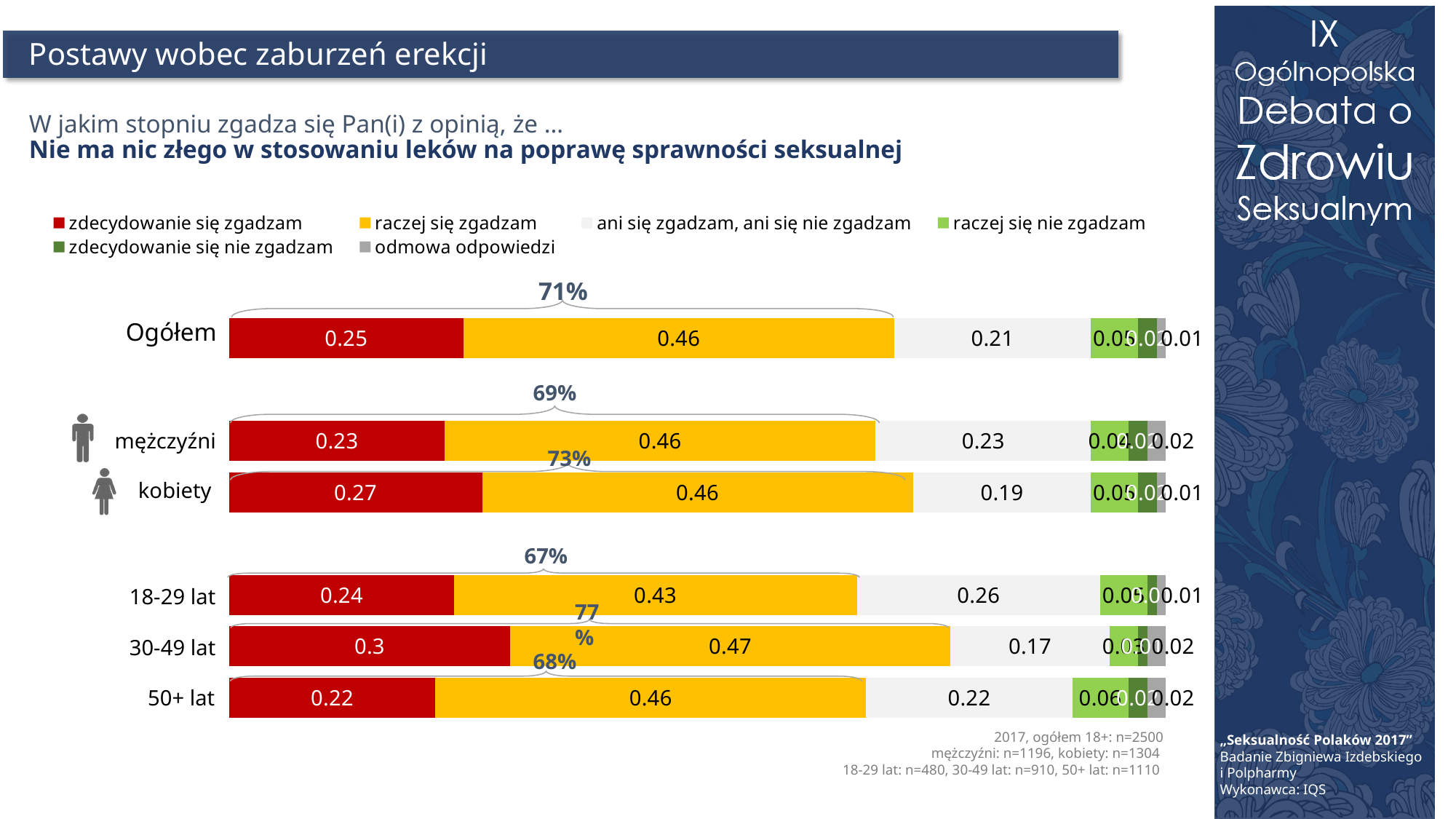
What is the value of "ani się zgadzam, ani się nie zgadzam" for 18-29 lat? 0.26 How many series does the legend list? 6 Which category has the highest value for "zdecydowanie się zgadzam"? 30-49 lat What is the value of "zdecydowanie się zgadzam" for Ogółem? 0.25 What is the value of "raczej się zgadzam" for 30-49 lat? 0.47 How many categories (bars) are plotted in the chart? 6 Which category has the highest combined agreement percentage shown above its bar? 30-49 lat What kind of chart is shown on the slide? stacked bar chart What combined percentage is shown above the bar for kobiety? 73% Which category has the lowest value for "zdecydowanie się zgadzam"? 50+ lat Which is larger: the "ani się zgadzam, ani się nie zgadzam" value for mężczyźni or for kobiety? mężczyźni What is the difference between the "zdecydowanie się zgadzam" values for kobiety and mężczyźni? 0.04